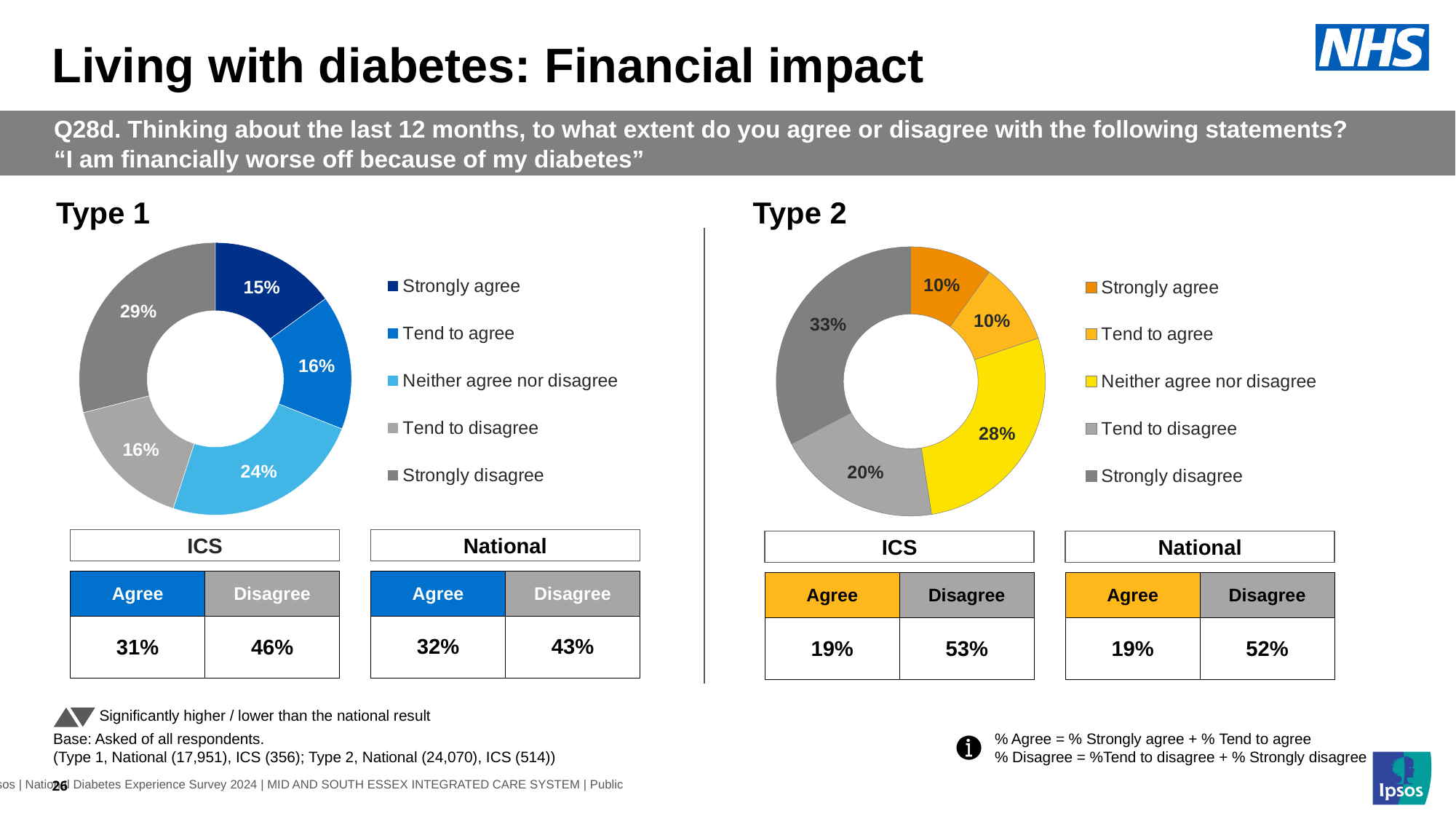
In the Type 1 chart, what percentage neither agree nor disagree? 24% In the Type 2 chart, what percentage tend to disagree? 20% In the Type 2 chart, what colour is the Neither agree nor disagree segment? Yellow In the Type 2 chart, which response category has the largest share? Strongly disagree In the Type 1 chart, what percentage of respondents strongly agree? 15% In the Type 2 chart, what percentage strongly disagree? 33% How many response categories does the Type 2 chart's legend list? 5 What kind of chart is used for Type 1? Donut (pie) chart In the Type 2 chart, what is the difference between the Strongly disagree share and the Neither agree nor disagree share? 5% In the Type 1 chart, which response category has the largest share? Strongly disagree In the Type 1 chart, which response category has the smallest share? Strongly agree In the Type 1 chart, which is larger: the Neither agree nor disagree share or the Tend to agree share? Neither agree nor disagree